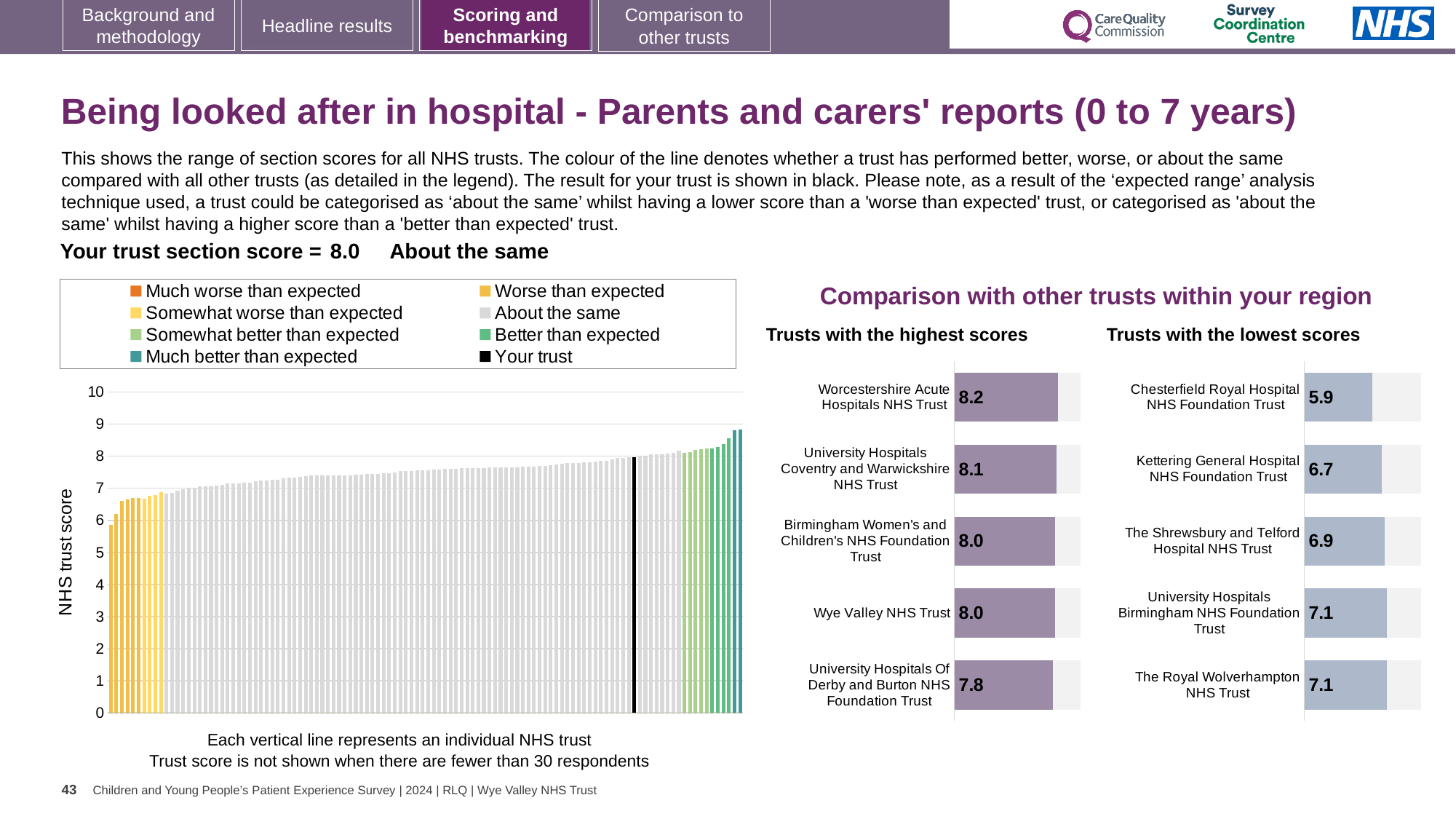
How many trusts are shown in the 'Trusts with the highest scores' chart? 5 In the 'Trusts with the highest scores' chart, what is the score for Worcestershire Acute Hospitals NHS Trust? 8.2 In the 'Trusts with the lowest scores' chart, what is the score for Kettering General Hospital NHS Foundation Trust? 6.7 In the 'Trusts with the highest scores' chart, which trust has the lowest score? University Hospitals Of Derby and Burton NHS Foundation Trust In the 'Trusts with the lowest scores' chart, which trust has the lowest score? Chesterfield Royal Hospital NHS Foundation Trust In the large chart on the left, do the trust scores rise or fall from left to right? rise How many entries does the legend above the large chart on the left list? 8 In the large chart on the left, is the value of the tallest bar greater or less than 8? greater In the 'Trusts with the highest scores' chart, what is the difference between the scores of Worcestershire Acute Hospitals NHS Trust and University Hospitals Of Derby and Burton NHS Foundation Trust? 0.4 In the large chart on the left, what is the label on the vertical axis? NHS trust score In the 'Trusts with the lowest scores' chart, which has the higher score: Kettering General Hospital NHS Foundation Trust or The Shrewsbury and Telford Hospital NHS Trust? The Shrewsbury and Telford Hospital NHS Trust What kind of chart is the large chart on the left showing NHS trust scores? bar chart